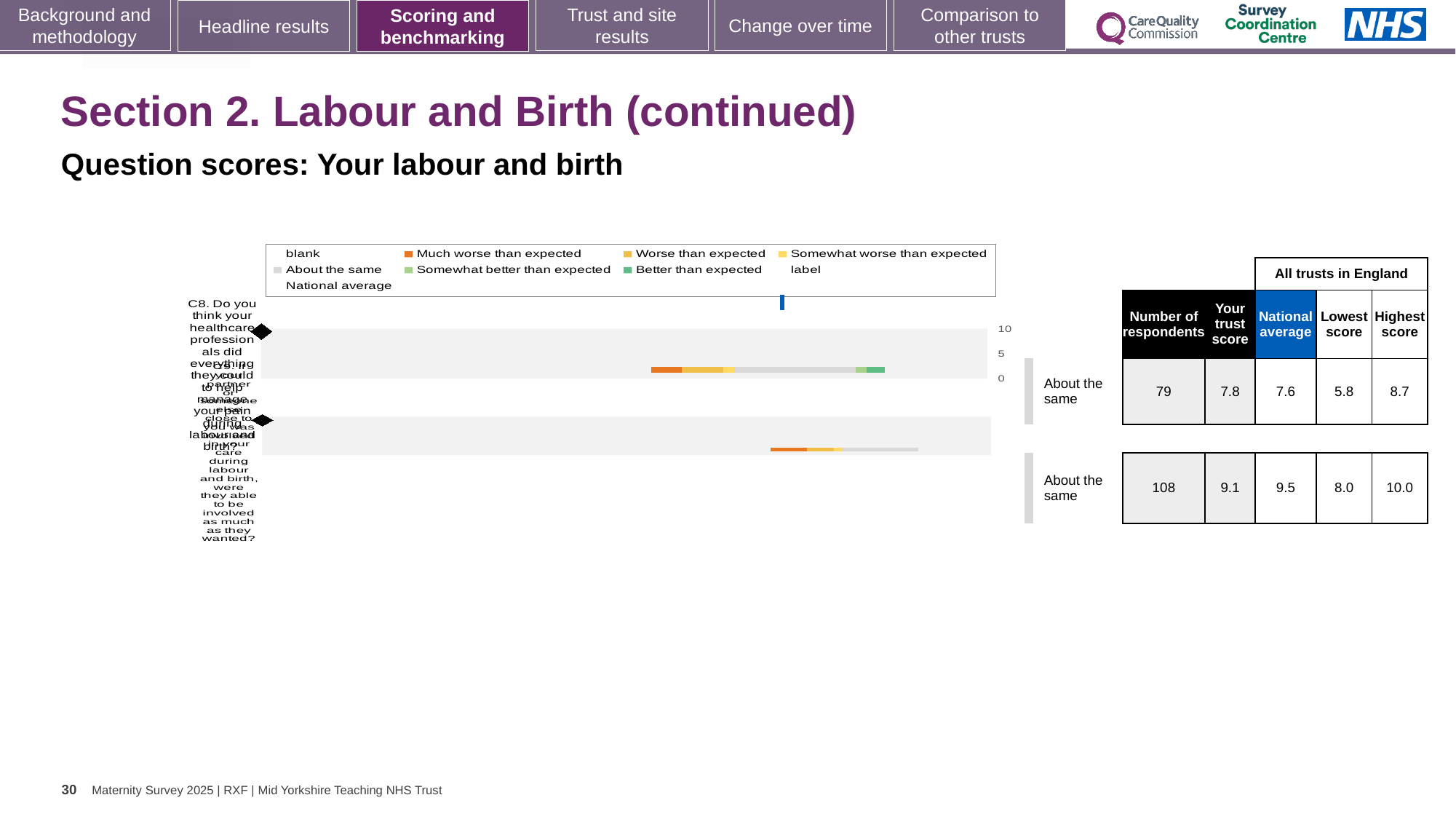
In the table beside the chart, what is the number of respondents for the second question row? 108 In the chart legend, what colour represents 'Better than expected'? green In the table beside the chart, what is the trust score for question C8? 7.8 In the table beside the chart, what is the number of respondents for question C8? 79 In the table beside the chart, what is the highest score in England for question C8? 8.7 What kind of chart is shown on the slide? bar chart For question C8, what is the difference between the highest score and the lowest score in England? 2.9 In the table beside the chart, what is the national average for question C8? 7.6 For the second question row, what is the difference between the highest score (10.0) and the lowest score (8.0)? 2.0 How many question rows (bars) are plotted in the chart? 2 In the chart legend, what colour represents 'Much worse than expected'? orange For question C8, which is larger: the trust score or the national average? trust score